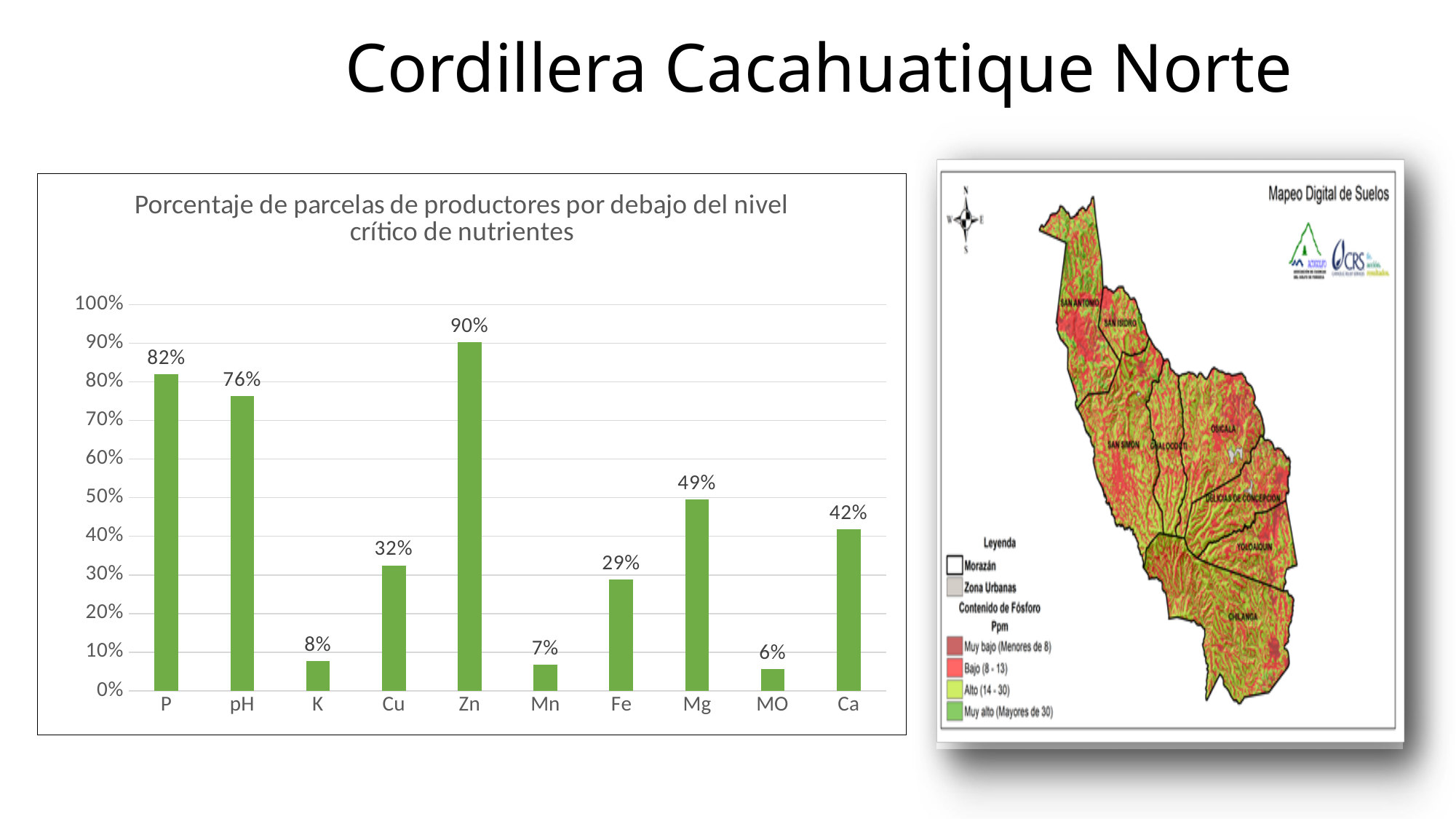
What is the difference between the values for P and pH? 6% What is the value for Mg? 49% Which is larger, the value for Cu or the value for Fe? Cu Is the value for Ca greater or less than 50%? less Which category has the lowest value? MO What is the value for MO? 6% How many categories are shown on the x axis? 10 What is the title of the chart? Porcentaje de parcelas de productores por debajo del nivel crítico de nutrientes What kind of chart is shown on the slide? bar chart Which category has the highest value? Zn What colour are the bars in the chart? green What is the value for Zn? 90%